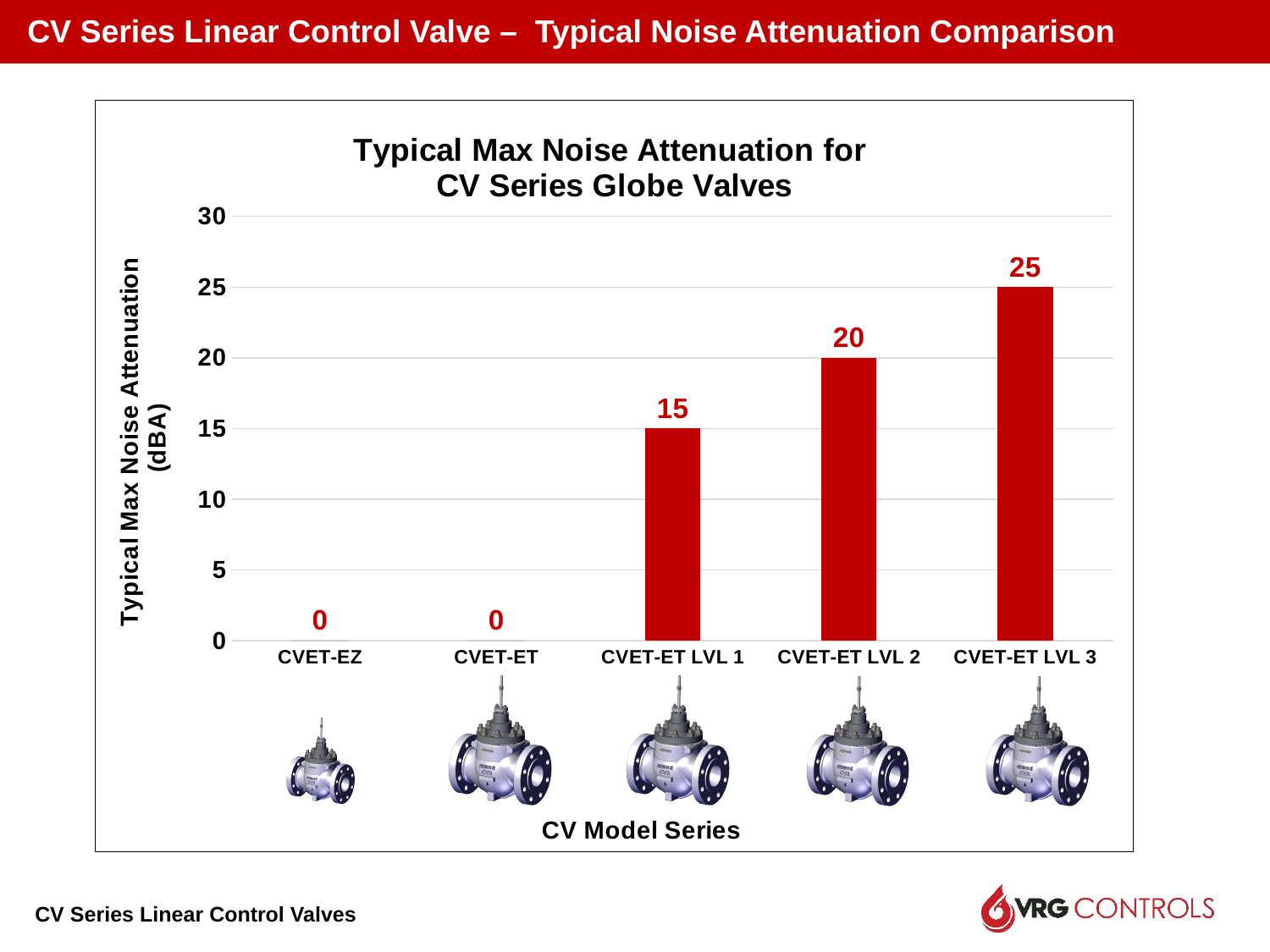
How many CV model series are shown on the x axis? 5 Is the value for CVET-ET LVL 2 greater or less than 10? greater What is the typical max noise attenuation for CVET-ET LVL 3? 25 What kind of chart is shown on the slide? Bar chart Do the values rise or fall moving from left to right along the x axis? Rise What is the typical max noise attenuation for CVET-ET LVL 1? 15 Which CV model series has the highest typical max noise attenuation? CVET-ET LVL 3 What is the typical max noise attenuation for CVET-EZ? 0 What is the difference in typical max noise attenuation between CVET-ET LVL 3 and CVET-ET LVL 1? 10 Which has a higher typical max noise attenuation, CVET-ET LVL 2 or CVET-ET LVL 1? CVET-ET LVL 2 What is the title of the chart? Typical Max Noise Attenuation for CV Series Globe Valves What is the difference in typical max noise attenuation between CVET-ET LVL 2 and CVET-ET? 20